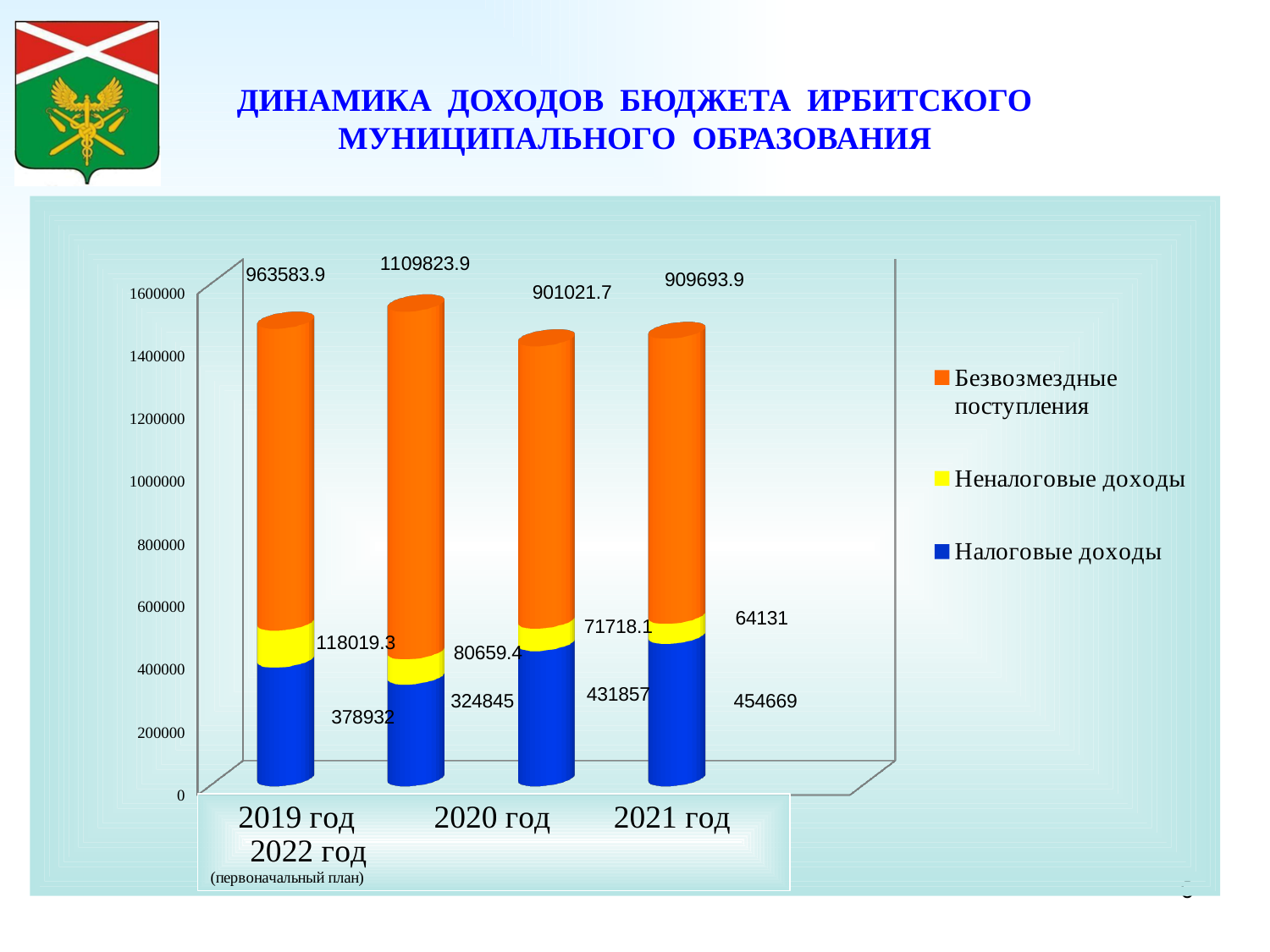
What is the total of the stacked bar for 2020 год? 1515328.3 What is the value of Налоговые доходы for 2022 год (первоначальный план)? 454669 In which year is Безвозмездные поступления the highest? 2020 год In which year is Неналоговые доходы the lowest? 2022 год (первоначальный план) What is the value of Налоговые доходы for 2019 год? 378932 What type of chart is shown on the slide? Stacked bar chart How many series does the legend list? 3 What is the value of Неналоговые доходы for 2021 год? 71718.1 What is the difference between Налоговые доходы in 2022 год and in 2021 год? 22812 Which is larger: Безвозмездные поступления in 2019 год or in 2021 год? 2019 год How many years (bars) are shown on the chart? 4 What is the value of Безвозмездные поступления for 2020 год? 1109823.9